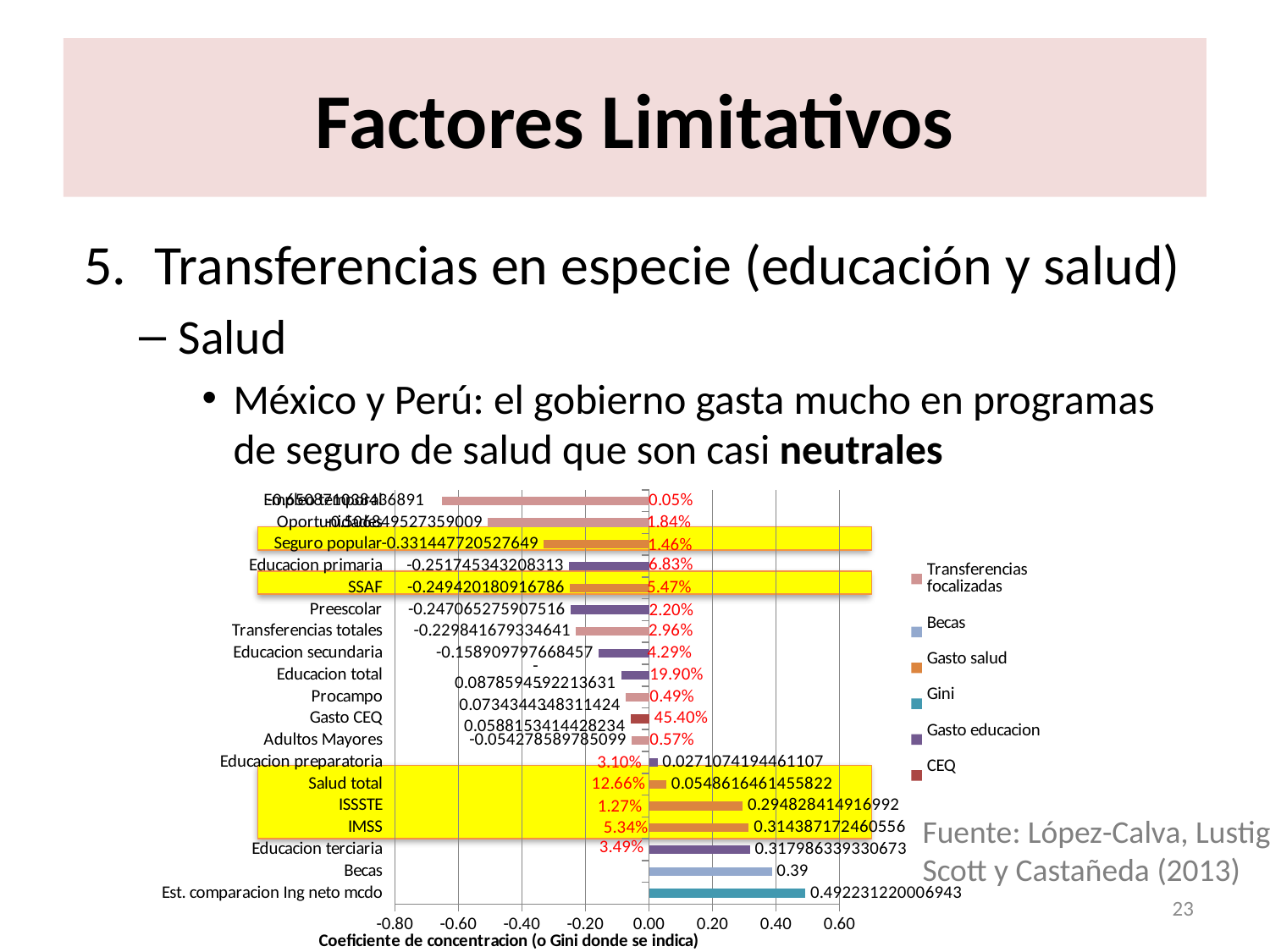
Which category has the lowest (most negative) value on the chart? Empleo temporal How many categories are plotted on the chart? 19 What kind of chart is shown on the slide? bar chart What is the difference between the value for Est. comparacion Ing neto mcdo and the value for Becas? 0.102231220006943 Is the value for Educacion terciaria greater or less than 0.20? greater Which has the larger value, ISSSTE or IMSS? IMSS What is the value shown for IMSS? 0.314387172460556 What is the concentration coefficient shown for Becas? 0.39 Which category has the highest value on the chart? Est. comparacion Ing neto mcdo How many series does the chart legend list? 6 What is the title of the horizontal axis of the chart? Coeficiente de concentracion (o Gini donde se indica) What is the value shown for Seguro popular? -0.331447720527649